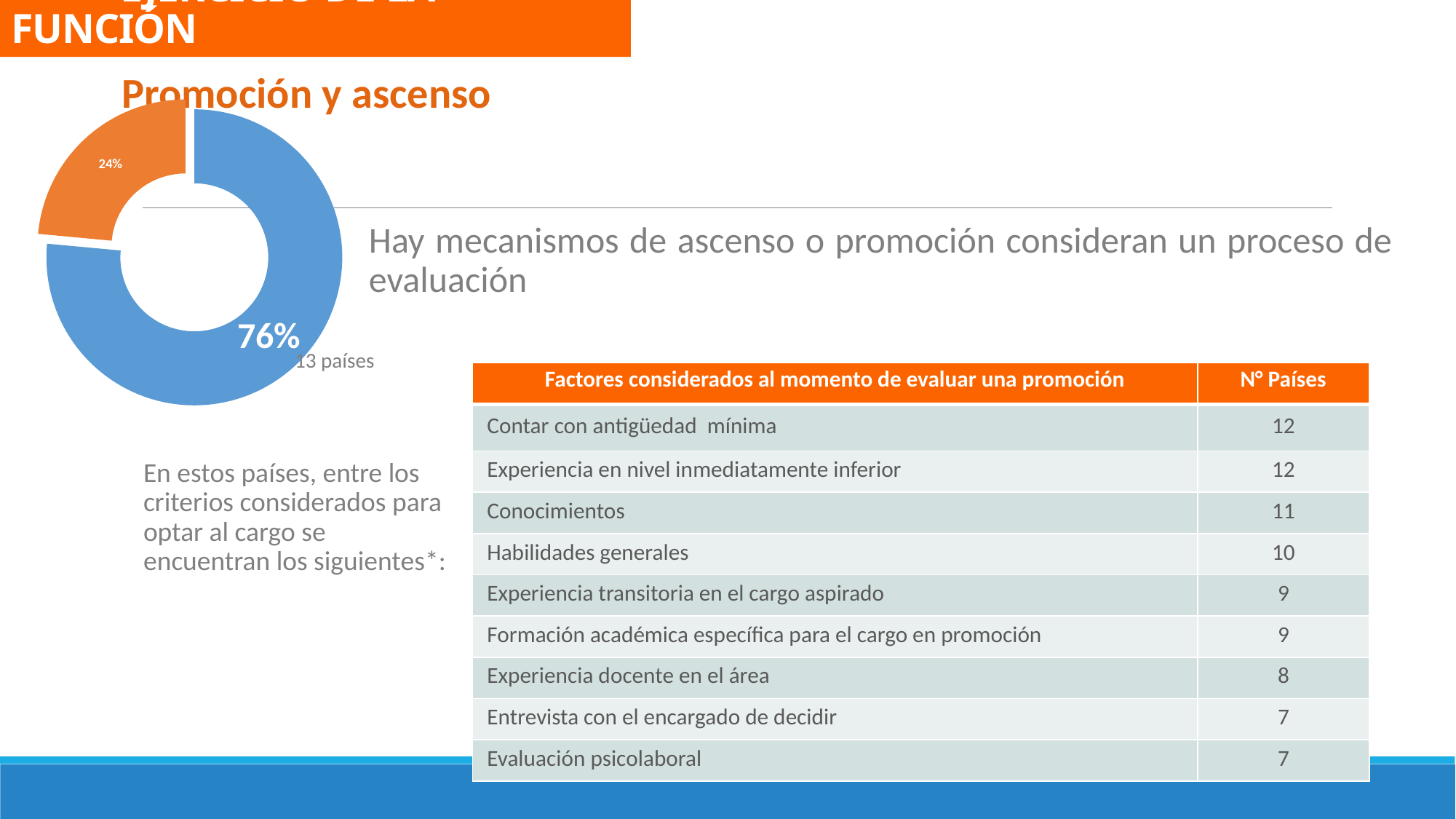
Which slice of the doughnut chart is the smallest? the orange slice (24%) What kind of chart is shown on the slide? doughnut chart Is the value of the orange slice of the doughnut chart greater or less than 50%? less What percentage is shown on the blue slice of the doughnut chart? 76% How many slices does the doughnut chart have? 2 Which slice of the doughnut chart is the largest? the blue slice (76%) What is the difference in percentage points between the blue slice and the orange slice of the doughnut chart? 52 Is the blue slice or the orange slice of the doughnut chart larger? the blue slice What percentage is shown on the orange slice of the doughnut chart? 24% What colour is the 24% slice of the doughnut chart? orange How many countries does the label next to the 76% slice of the doughnut chart mention? 13 países